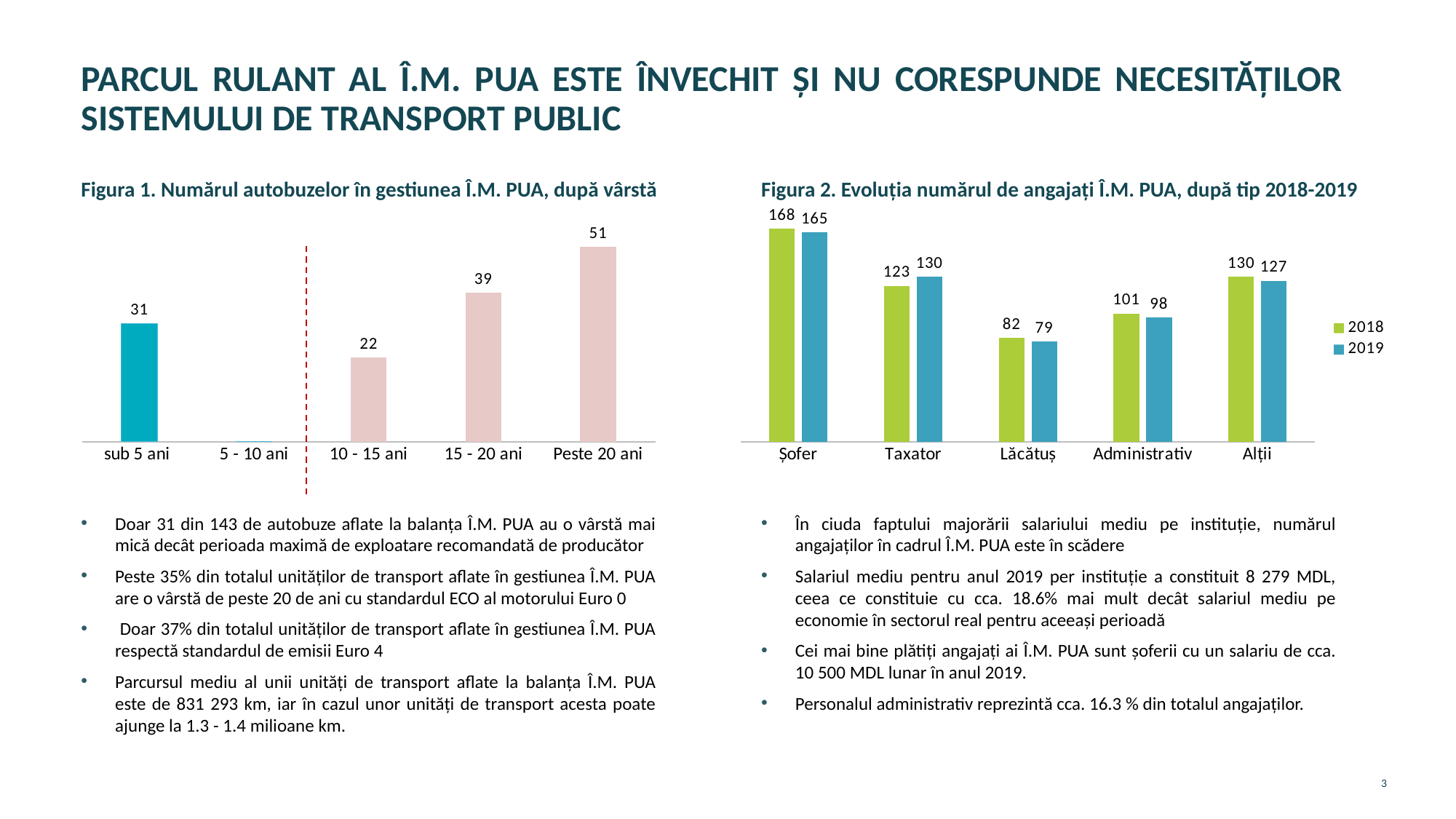
In Figura 1, how many age categories are shown on the x axis? 5 In Figura 2, which employee type has the lowest 2019 value? Lăcătuș In Figura 2, what is the 2018 value for Administrativ? 101 In Figura 2, what is the 2019 value for Taxator? 130 What type of chart is Figura 2? Bar chart In Figura 1, which age category has the highest number of buses? Peste 20 ani In Figura 1, how many buses are in the 'Peste 20 ani' category? 51 In Figura 2, which employee type has the highest 2018 value? Șofer In Figura 1, which is larger: the value for 'sub 5 ani' or for '10 - 15 ani'? sub 5 ani In Figura 1, what is the difference between the '15 - 20 ani' and '10 - 15 ani' values? 17 In Figura 2, how many series does the legend list? 2 In Figura 2, what is the difference between the 2018 and 2019 values for Șofer? 3